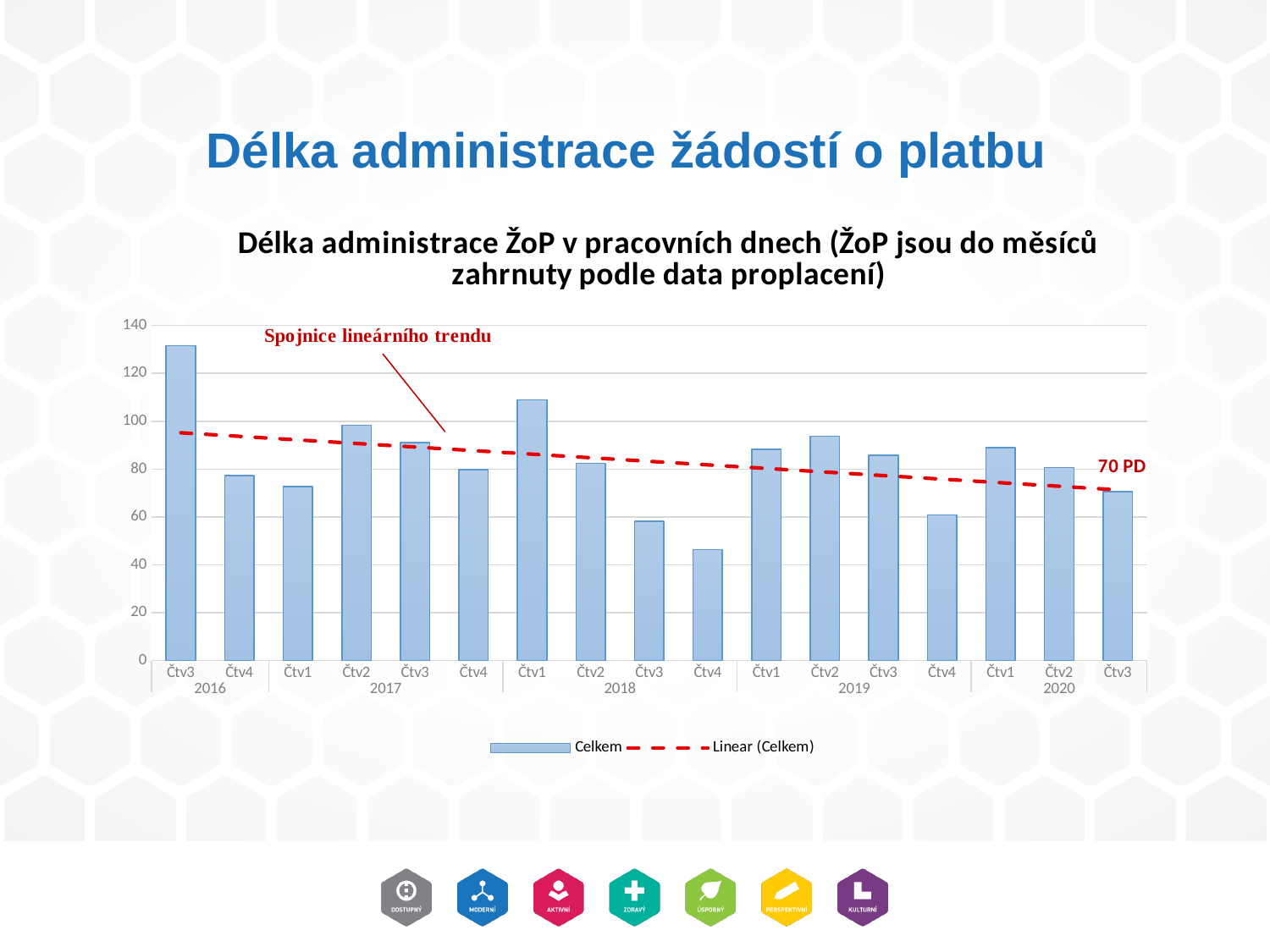
Is the value for Čtv1 2018 greater or less than 100? greater Which quarter has the lowest bar in the chart? Čtv4 2018 Does the dashed linear trend line rise or fall from left to right across the chart? fall How many bars (quarters) are plotted in the chart? 17 Which is larger, the value for Čtv1 2017 or the value for Čtv2 2017? Čtv2 2017 Which quarter has the highest bar in the chart? Čtv3 2016 Is the value for Čtv4 2018 greater or less than 60? less What value annotation is written in red at the right end of the trend line? 70 PD What kind of chart is shown on the slide? bar chart Is the value for Čtv3 2016 greater or less than 120? greater What is the legend label of the dashed red line in the chart? Linear (Celkem) How many entries does the chart legend list? 2